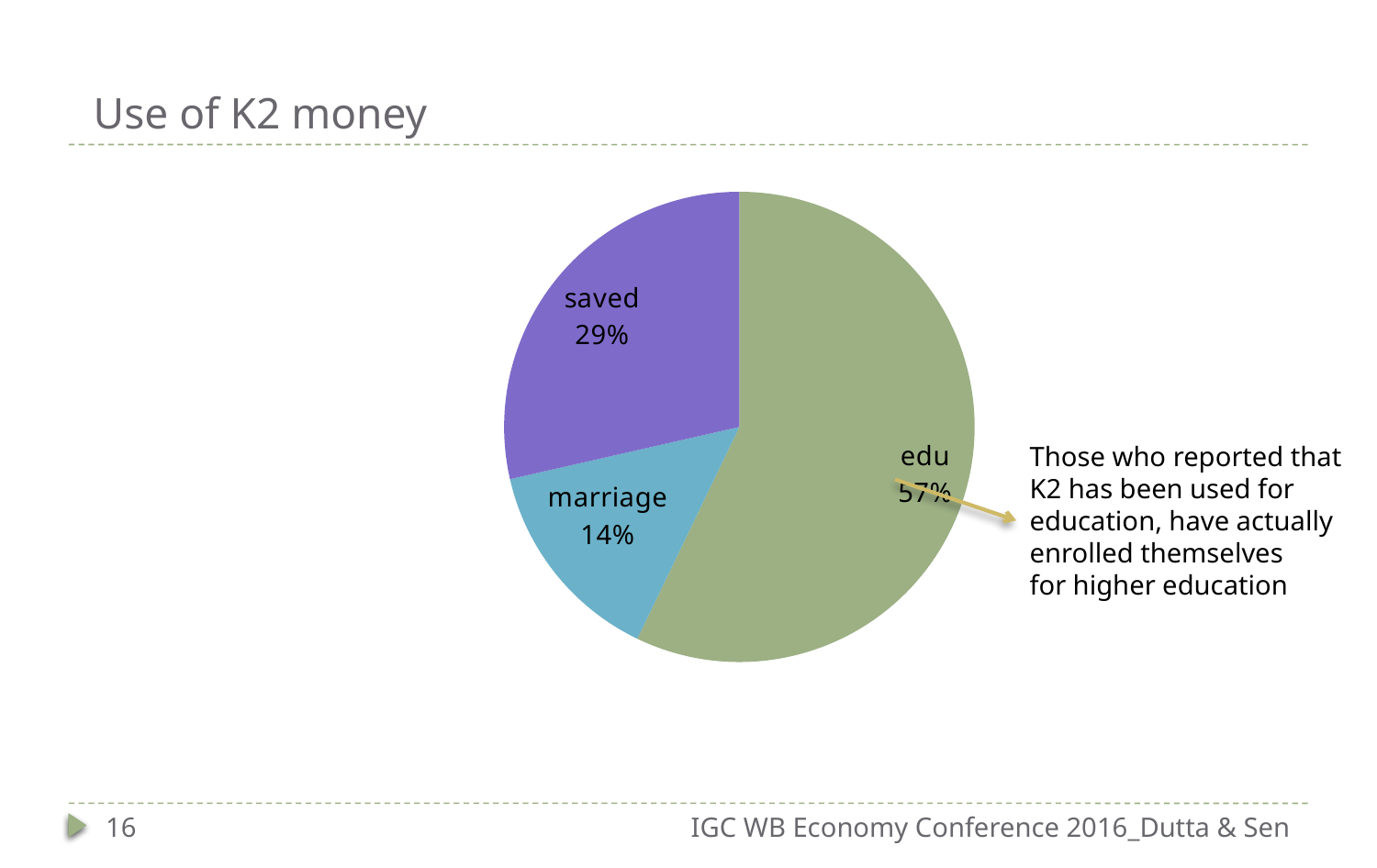
Which slice of the pie is the smallest? marriage Which is larger, the 'saved' slice or the 'marriage' slice? saved What is the title of the slide containing the pie chart? Use of K2 money What kind of chart is shown on the slide? pie chart What share of K2 money use is labelled 'edu'? 57% How many slices does the pie chart have? 3 What share of K2 money use is labelled 'marriage'? 14% What share of K2 money use is labelled 'saved'? 29% What colour is the 'marriage' slice of the pie? blue What is the difference in percentage points between the 'edu' and 'saved' slices? 28 What is the difference in percentage points between the 'saved' and 'marriage' slices? 15 Which slice of the pie is the largest? edu